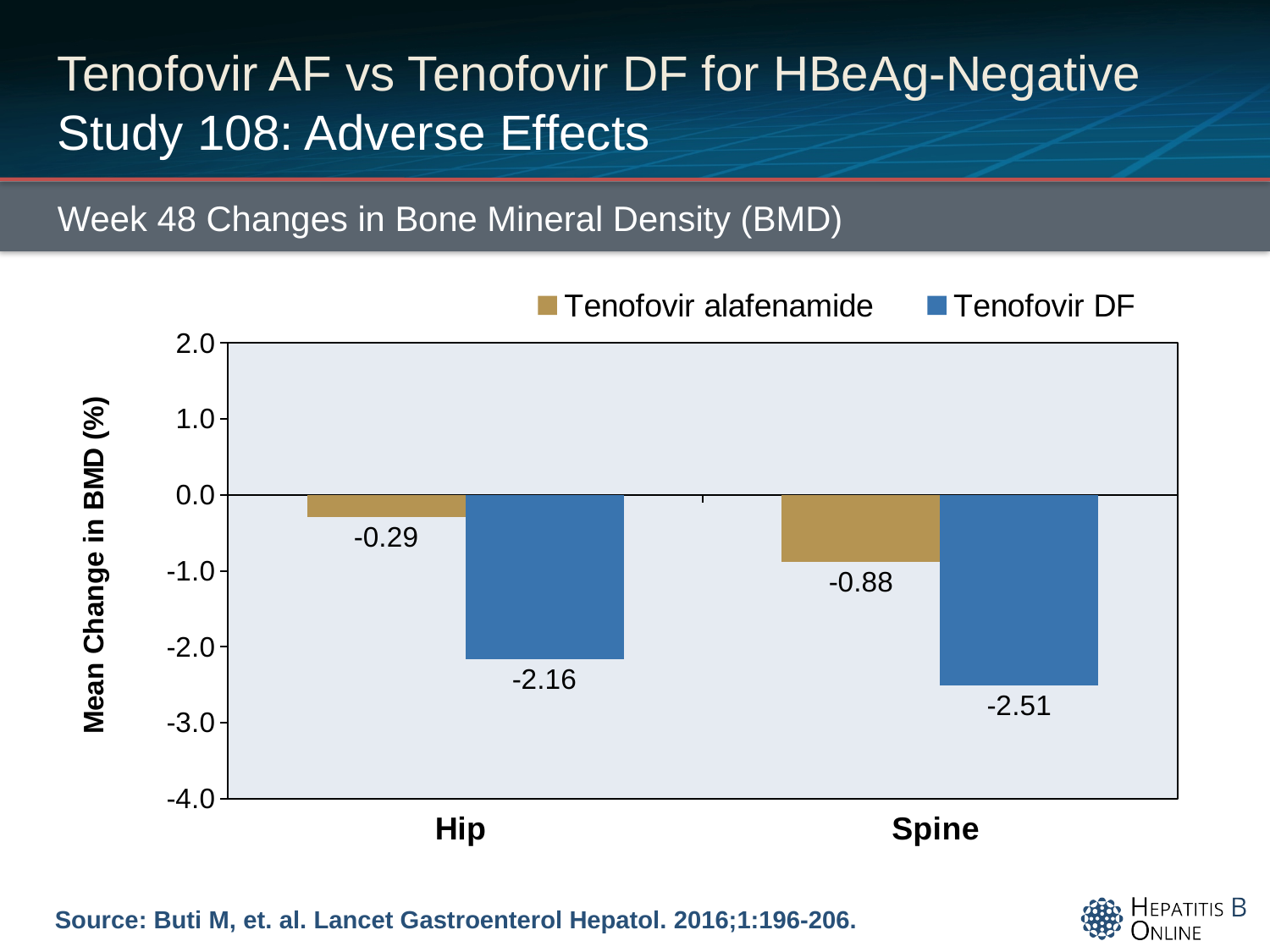
What kind of chart is shown on the slide? Bar chart What is the difference between the Tenofovir DF and Tenofovir alafenamide values at the Hip? 1.87 What is the difference between the Tenofovir DF and Tenofovir alafenamide values at the Spine? 1.63 What is the mean change in BMD for Tenofovir alafenamide at the Spine? -0.88 What is the mean change in BMD for Tenofovir DF at the Spine? -2.51 Which bar shows the largest decrease in BMD? Tenofovir DF at the Spine Which bar shows the smallest decrease in BMD? Tenofovir alafenamide at the Hip How many categories are shown on the x axis? 2 What is the mean change in BMD for Tenofovir DF at the Hip? -2.16 What is the mean change in BMD for Tenofovir alafenamide at the Hip? -0.29 How many series does the legend list? 2 Which treatment shows a larger decrease in BMD at the Spine, Tenofovir alafenamide or Tenofovir DF? Tenofovir DF